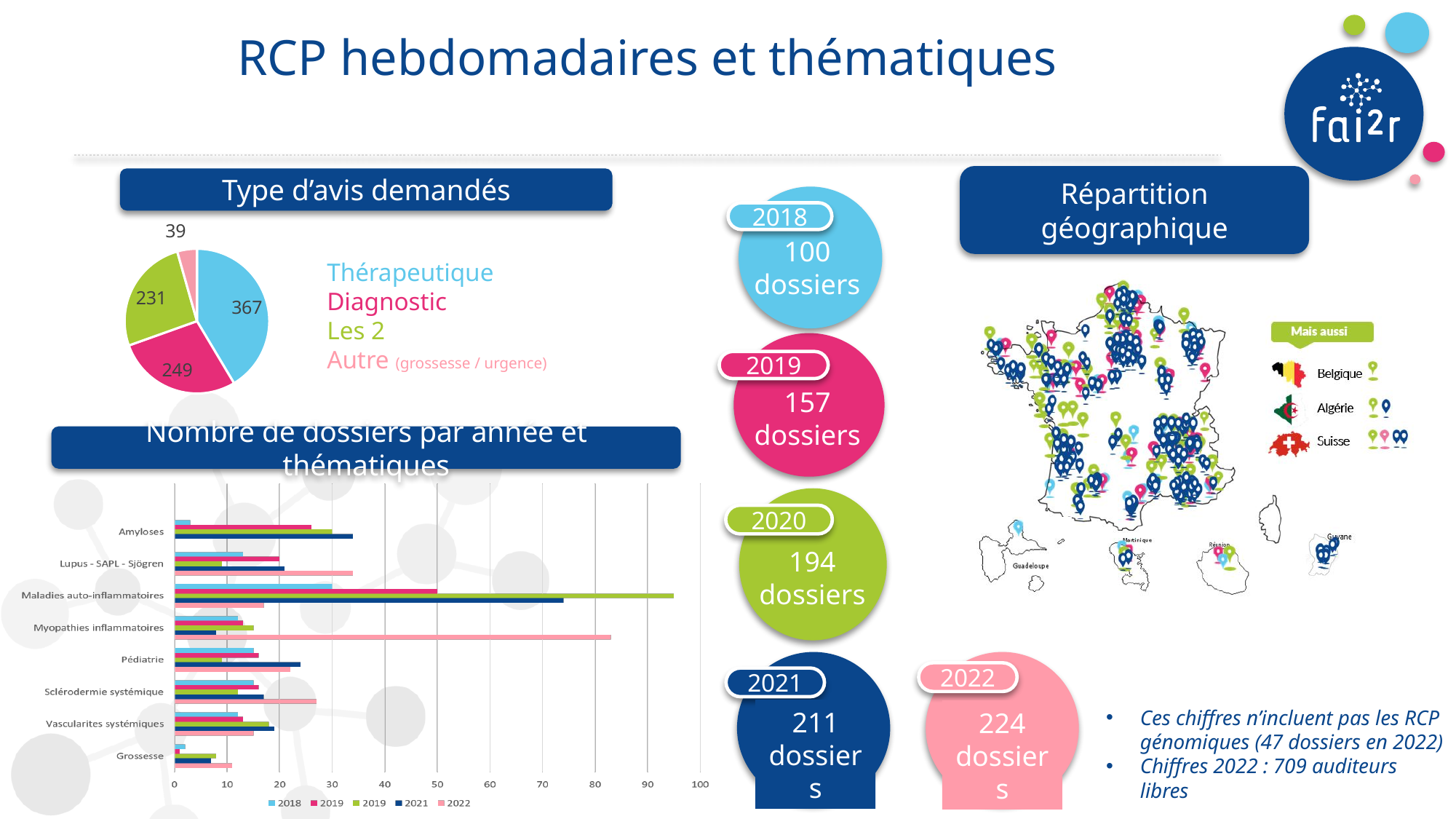
What kind of chart is 'Nombre de dossiers par année et thématiques'? bar chart In the pie chart 'Type d'avis demandés', how many slices are there? 4 In the bar chart 'Nombre de dossiers par année et thématiques', how many series does the legend list? 5 In the bar chart 'Nombre de dossiers par année et thématiques', is the 2022 value for Myopathies inflammatoires greater or less than 80? greater In the bar chart 'Nombre de dossiers par année et thématiques', how many categories are shown on the vertical axis? 8 In the pie chart 'Type d'avis demandés', what is the value for Diagnostic? 249 In the pie chart 'Type d'avis demandés', what is the value for Autre (grossesse / urgence)? 39 In the pie chart 'Type d'avis demandés', what is the difference between the Diagnostic value and the Les 2 value? 18 In the pie chart 'Type d'avis demandés', which category has the largest slice? Thérapeutique In the pie chart 'Type d'avis demandés', which category has the smallest slice? Autre (grossesse / urgence) In the pie chart 'Type d'avis demandés', what is the value for Thérapeutique? 367